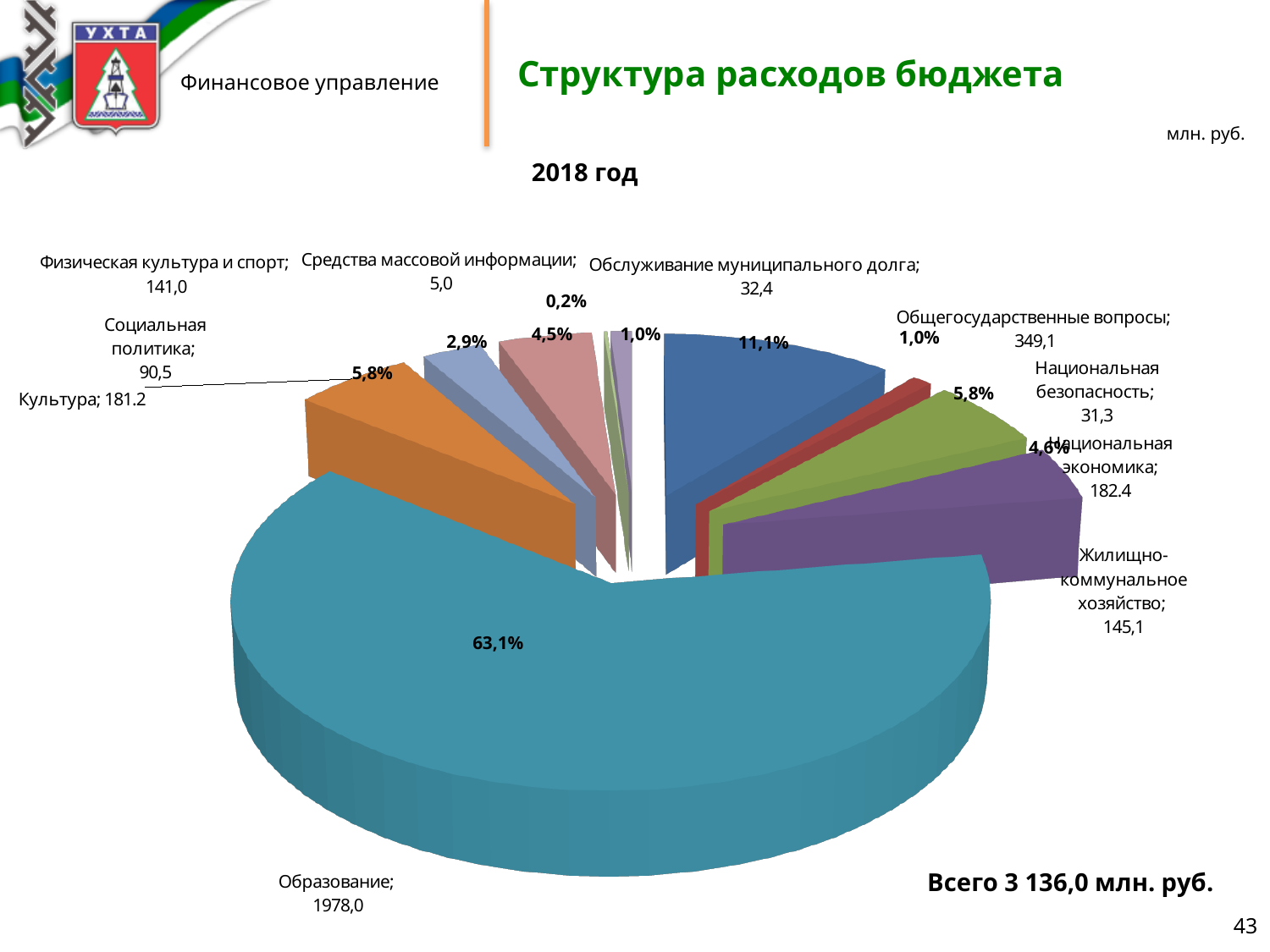
What is the value for Средства массовой информации? 5,0 What share of the pie does Образование represent? 63,1% What share of the pie does Общегосударственные вопросы represent? 11,1% Which category has the smallest value? Средства массовой информации What is the value for Образование? 1978,0 What type of chart is shown on the slide? Pie chart What is the difference between the values for Образование and Общегосударственные вопросы? 1628,9 Which category has the largest share of the pie? Образование Which is larger: Жилищно-коммунальное хозяйство or Физическая культура и спорт? Жилищно-коммунальное хозяйство What is the value for Общегосударственные вопросы? 349,1 How many categories does the pie chart contain? 10 What is the value for Жилищно-коммунальное хозяйство? 145,1